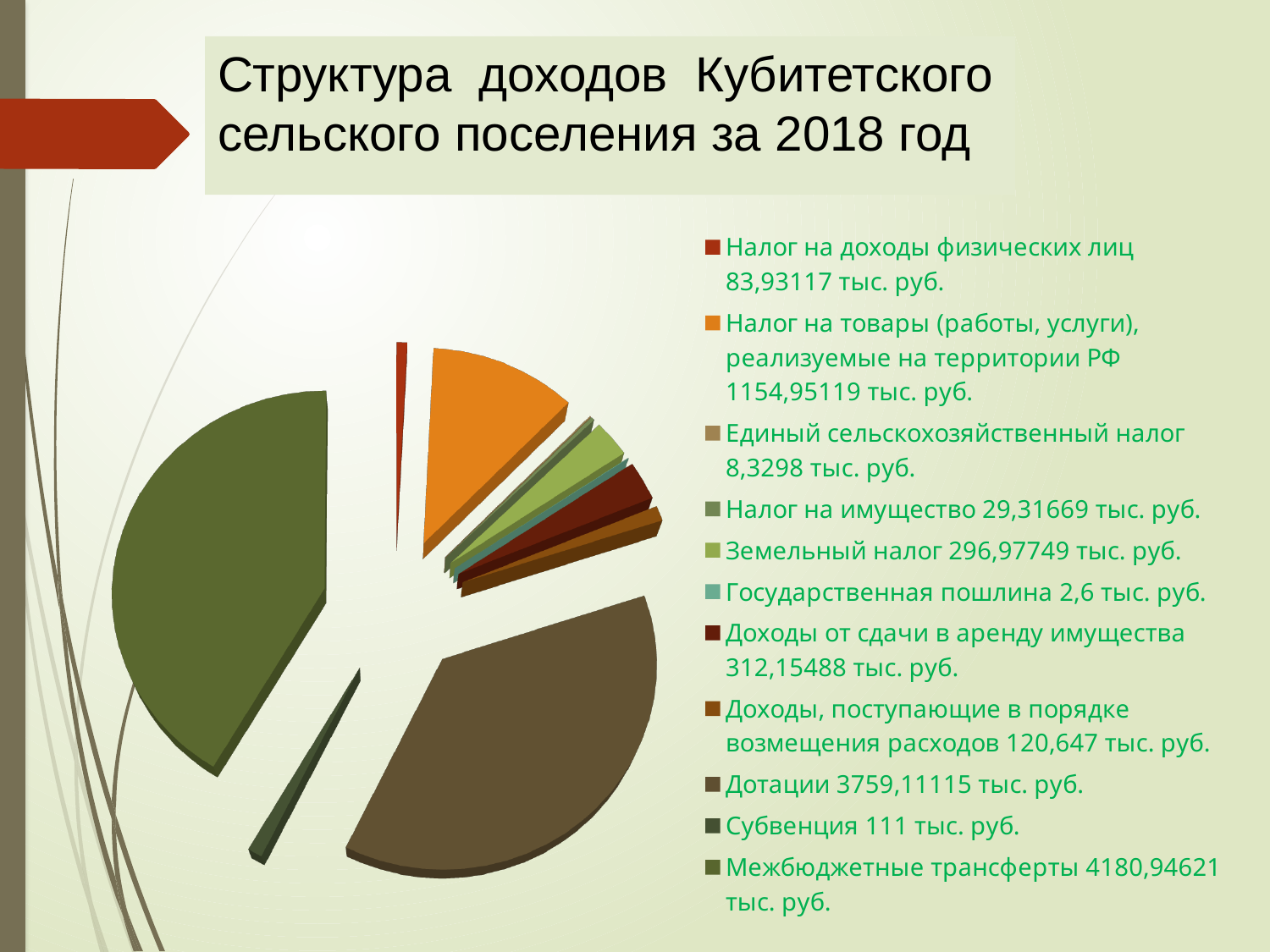
What is the difference between Субвенция and Налог на доходы физических лиц? 27,06883 тыс. руб. What kind of chart is shown on the slide? Pie chart Which category has the highest value in the pie chart? Межбюджетные трансферты Which category has the lowest value in the pie chart? Государственная пошлина How many categories does the legend of the pie chart list? 11 What is the title of the chart on the slide? Структура доходов Кубитетского сельского поселения за 2018 год What is the value for Межбюджетные трансферты? 4180,94621 тыс. руб. What is the value for Земельный налог? 296,97749 тыс. руб. What is the value for Дотации? 3759,11115 тыс. руб. Which is larger: Дотации or Налог на товары (работы, услуги), реализуемые на территории РФ? Дотации What is the value for Государственная пошлина? 2,6 тыс. руб. What is the difference between Межбюджетные трансферты and Дотации? 421,83506 тыс. руб.